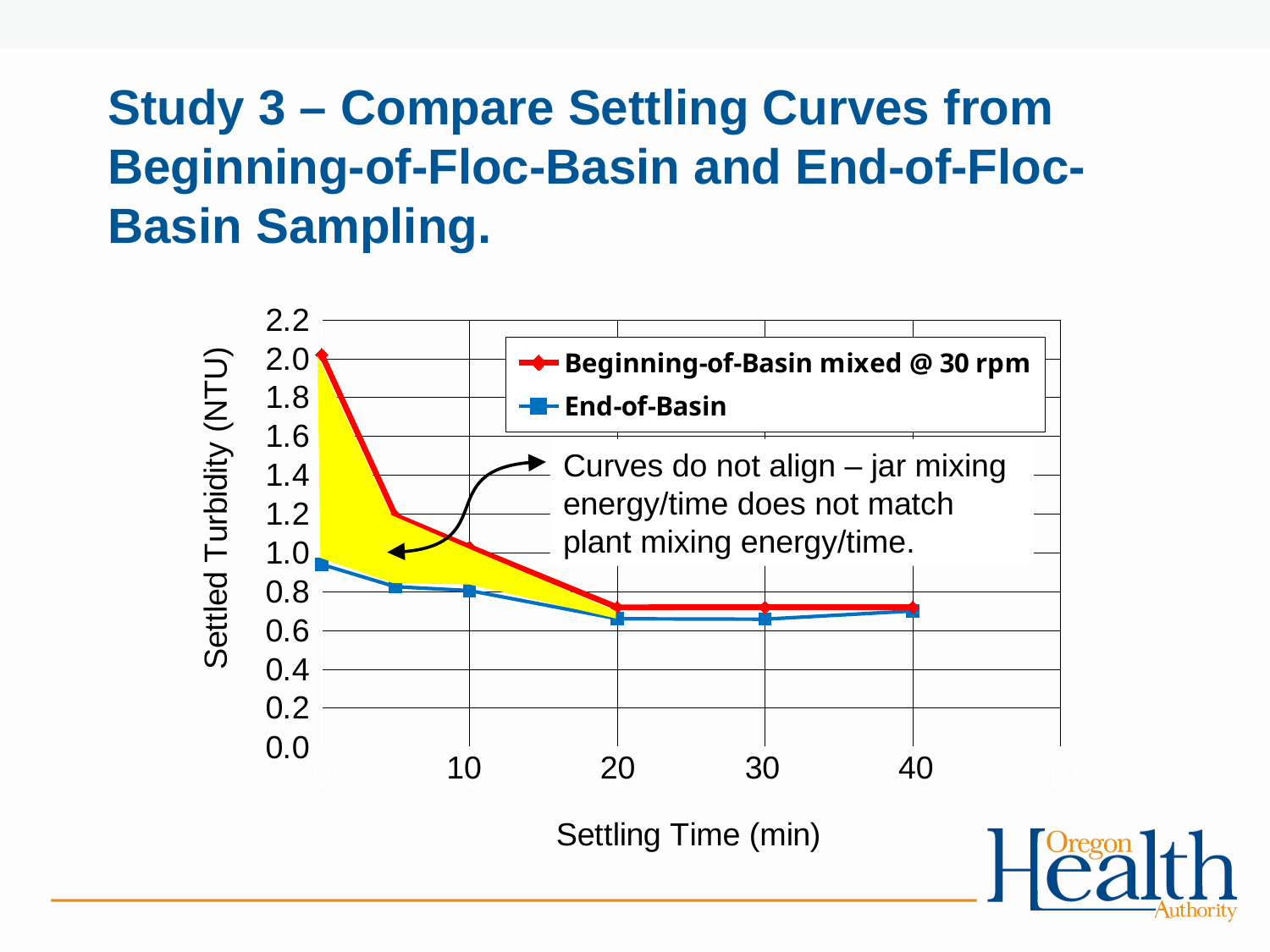
Which series has the higher settled turbidity at 10 min settling time? Beginning-of-Basin mixed @ 30 rpm Is the End-of-Basin value at 0 min settling time greater or less than 1.2? less Which series is drawn in red? Beginning-of-Basin mixed @ 30 rpm Does the Beginning-of-Basin mixed @ 30 rpm curve rise or fall as settling time increases from 0 to 20 min? fall What kind of chart is shown on the slide? line chart How many series does the legend list? 2 Is the End-of-Basin value at 30 min settling time greater or less than 0.4? greater Is the Beginning-of-Basin mixed @ 30 rpm value at 20 min settling time greater or less than 1.0? less At which settling time does the Beginning-of-Basin mixed @ 30 rpm series reach its highest settled turbidity? 0 min Which series has the higher settled turbidity at 0 min settling time? Beginning-of-Basin mixed @ 30 rpm What is the label of the y axis? Settled Turbidity (NTU)